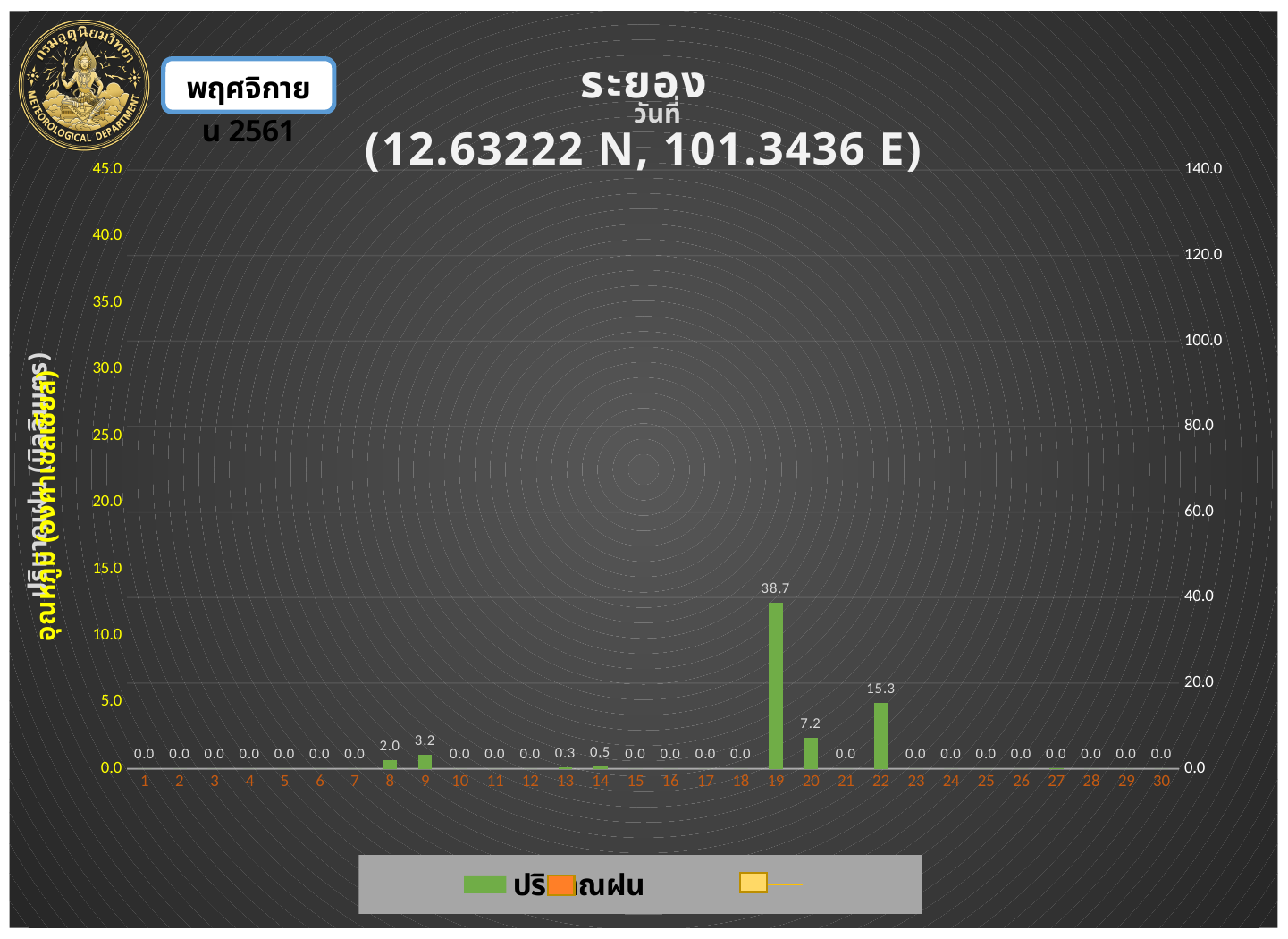
What is the rainfall value shown for day 19? 38.7 Which is larger, the value for day 20 or the value for day 22? day 22 Which day has the highest bar in the chart? 19 What is the value shown for day 9? 3.2 How many days (categories) are shown on the x axis? 30 What is the difference between the values for day 19 and day 22? 23.4 What is the difference between the values for day 9 and day 8? 1.2 What is the value labelled on the bar for day 22? 15.3 What type of chart is shown on the slide? bar chart What is the value shown for day 14? 0.5 What are the coordinates given in the chart title? 12.63222 N, 101.3436 E What is the value shown for day 20? 7.2